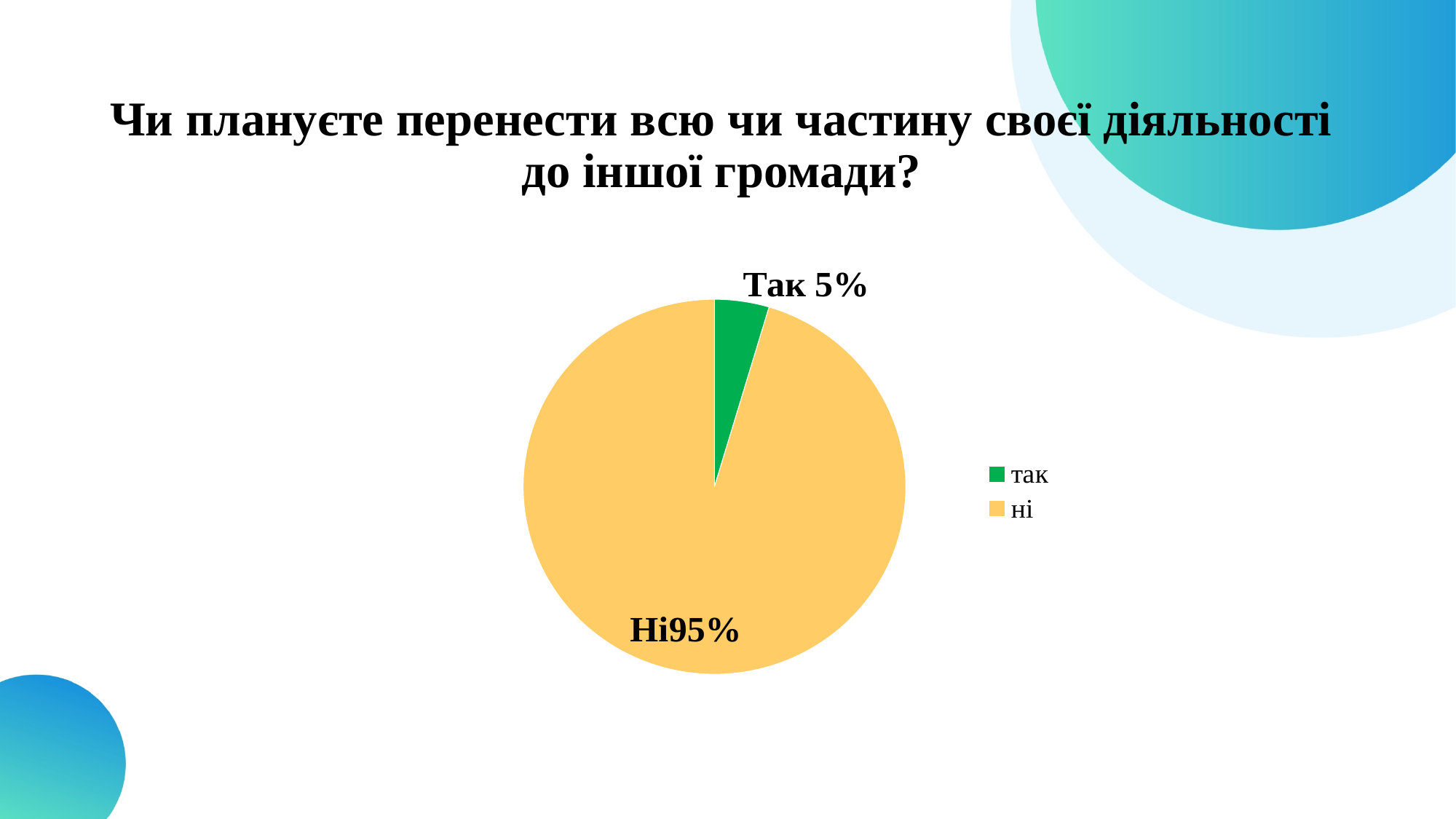
What is the difference in percentage points between the "ні" and "так" slices? 90 What colour is the "ні" slice? orange What colour is the "так" slice? green What kind of chart is shown on the slide? pie chart How many slices does the pie chart have? 2 Which slice is larger, "так" or "ні"? ні What percentage of respondents answered "так" (yes)? 5% Which answer has the smallest share of the pie? так What percentage of respondents answered "ні" (no)? 95% Which answer has the largest share of the pie? ні What share of the pie does the "ні" slice represent? 95% How many entries does the legend list? 2